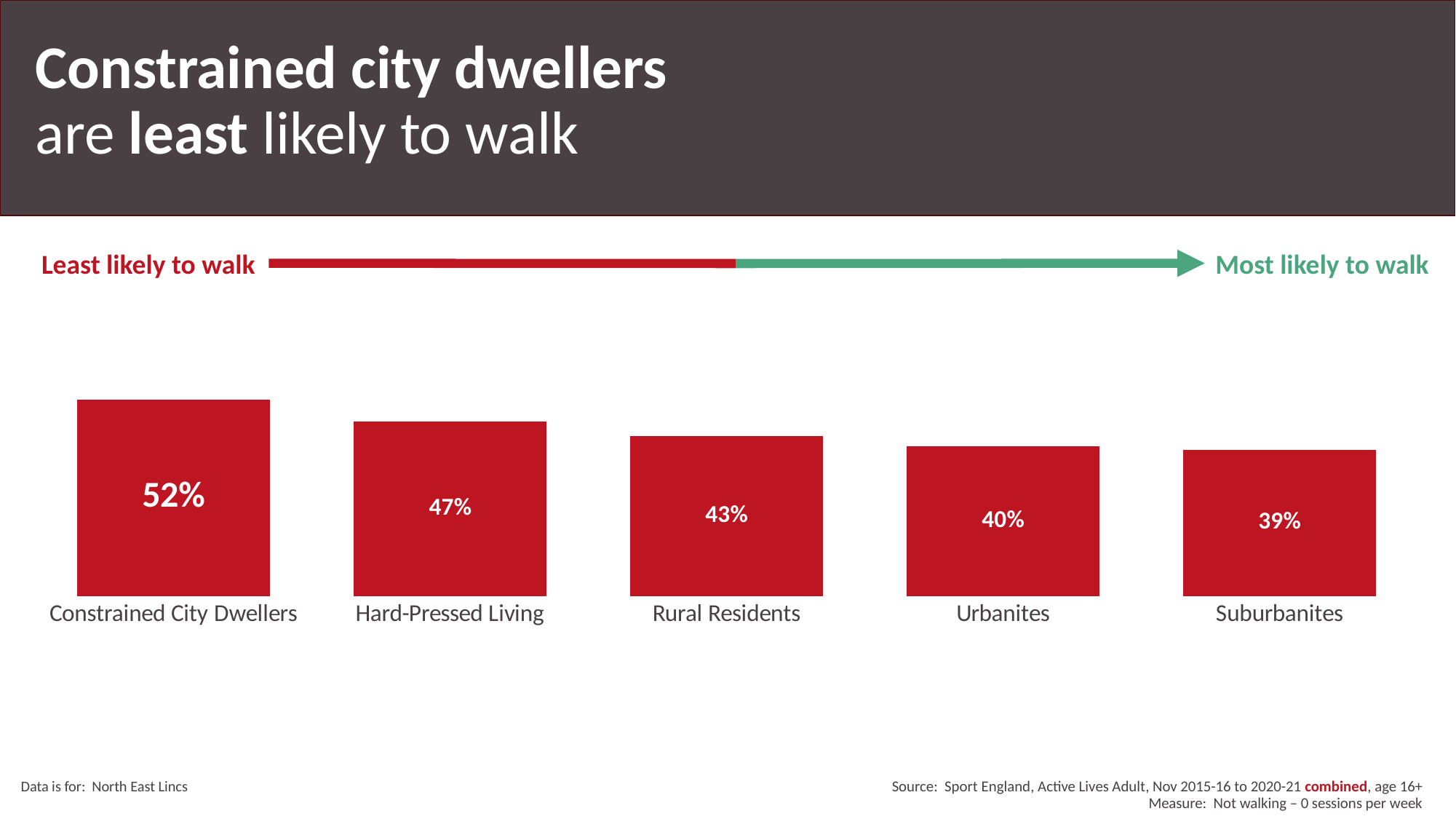
What is the difference between the values for Hard-Pressed Living and Rural Residents? 4% What is the difference between the values for Constrained City Dwellers and Suburbanites? 13% What is the value for Rural Residents? 43% Which category has the lowest value? Suburbanites What is the value for Constrained City Dwellers? 52% What is the value for Hard-Pressed Living? 47% Which is larger, the value for Rural Residents or the value for Urbanites? Rural Residents How many categories are shown in the chart? 5 Which category has the highest value? Constrained City Dwellers Do the values rise or fall from left to right across the categories? fall What is the value for Urbanites? 40% What is the value for Suburbanites? 39%